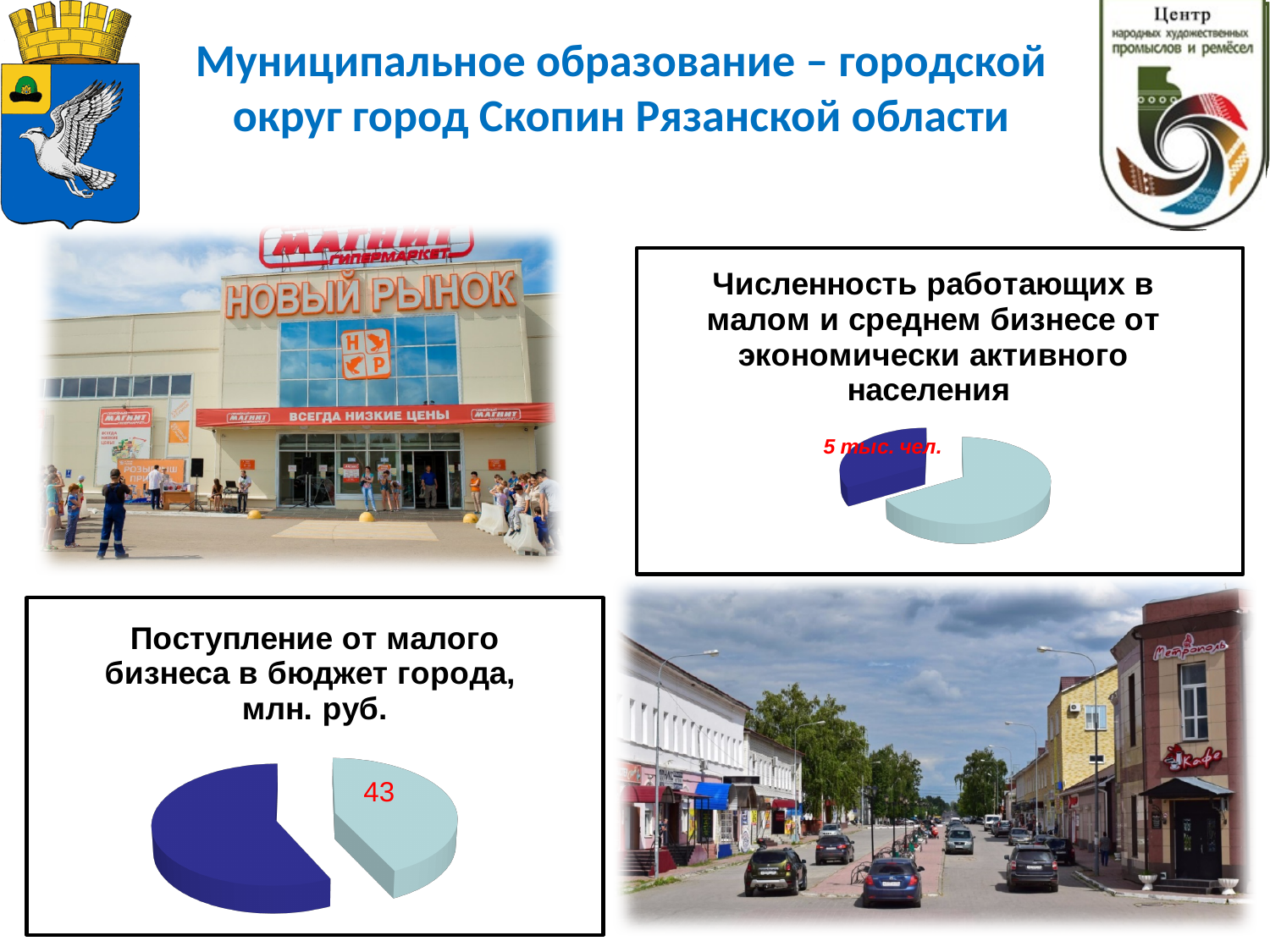
What kind of chart is shown under the title "Поступление от малого бизнеса в бюджет города, млн. руб."? pie chart How many slices does the pie chart "Численность работающих в малом и среднем бизнесе от экономически активного населения" have? 2 In the chart "Поступление от малого бизнеса в бюджет города, млн. руб.", what value is printed on the light blue slice? 43 In the chart "Поступление от малого бизнеса в бюджет города, млн. руб.", is the slice labelled 43 the larger or the smaller slice of the pie? the smaller slice What unit is stated in the title of the pie chart in the lower-left box of the slide? млн. руб. In the chart "Численность работающих в малом и среднем бизнесе от экономически активного населения", what value is printed on the dark blue slice? 5 тыс. чел. In the chart "Поступление от малого бизнеса в бюджет города, млн. руб.", which slice is larger, the dark blue one or the light blue one? the dark blue one What kind of chart is shown under the title "Численность работающих в малом и среднем бизнесе от экономически активного населения"? pie chart How many slices does the pie chart "Поступление от малого бизнеса в бюджет города, млн. руб." have? 2 What is the title of the pie chart in the upper-right box of the slide? Численность работающих в малом и среднем бизнесе от экономически активного населения In the chart "Численность работающих в малом и среднем бизнесе от экономически активного населения", which slice is larger, the dark blue one or the light blue one? the light blue one